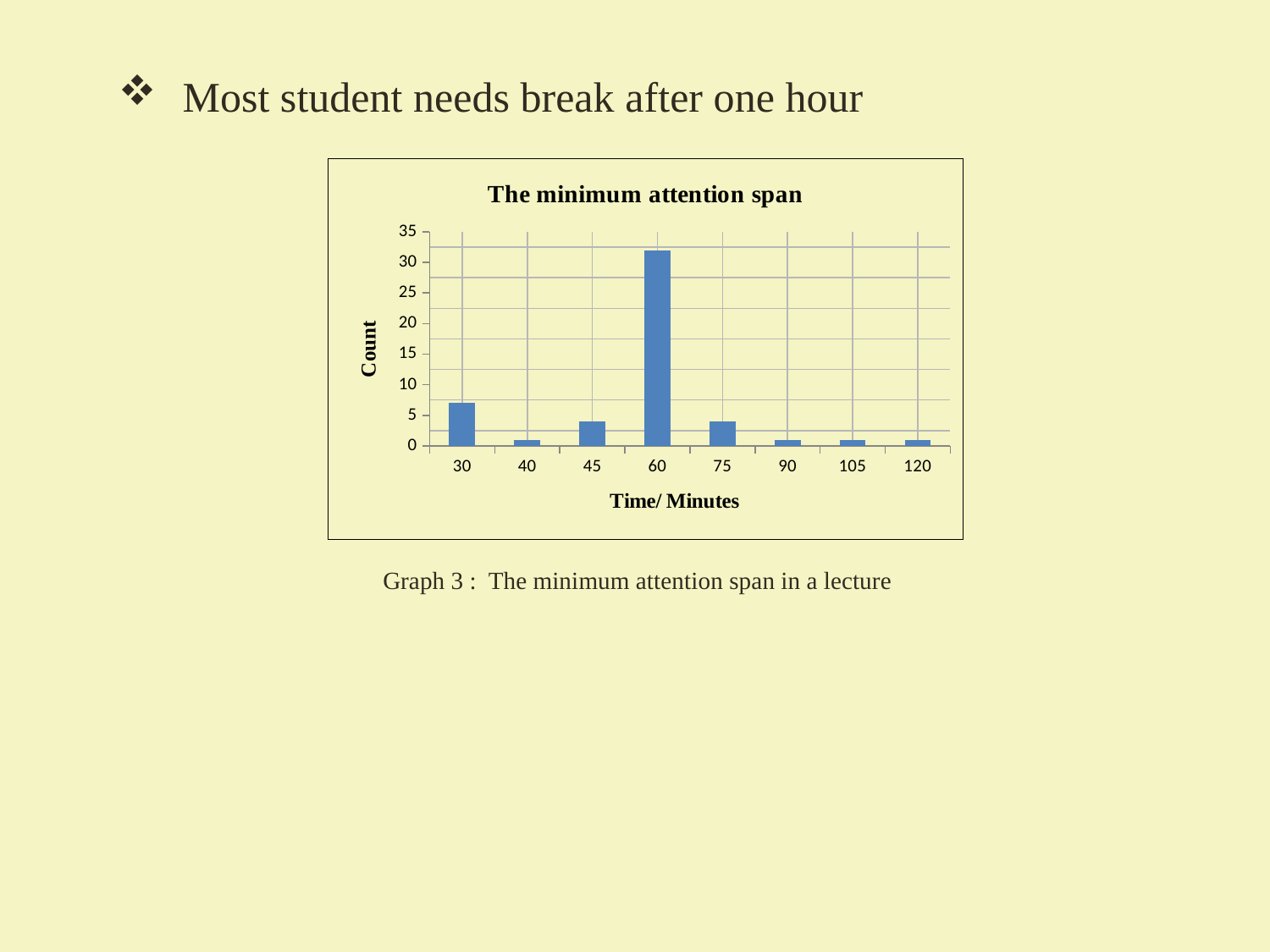
What kind of chart is shown on the slide? bar chart Which time category has the highest count? 60 Is the count for 30 minutes greater or less than 5? greater Is the count for 40 minutes greater or less than 5? less What is the label of the x axis of the chart? Time/ Minutes Is the count for 45 minutes greater or less than 5? less How many time categories are shown on the x axis of the chart? 8 What is the title of the chart? The minimum attention span Which has a higher count, 60 minutes or 75 minutes? 60 Which has a higher count, 30 minutes or 45 minutes? 30